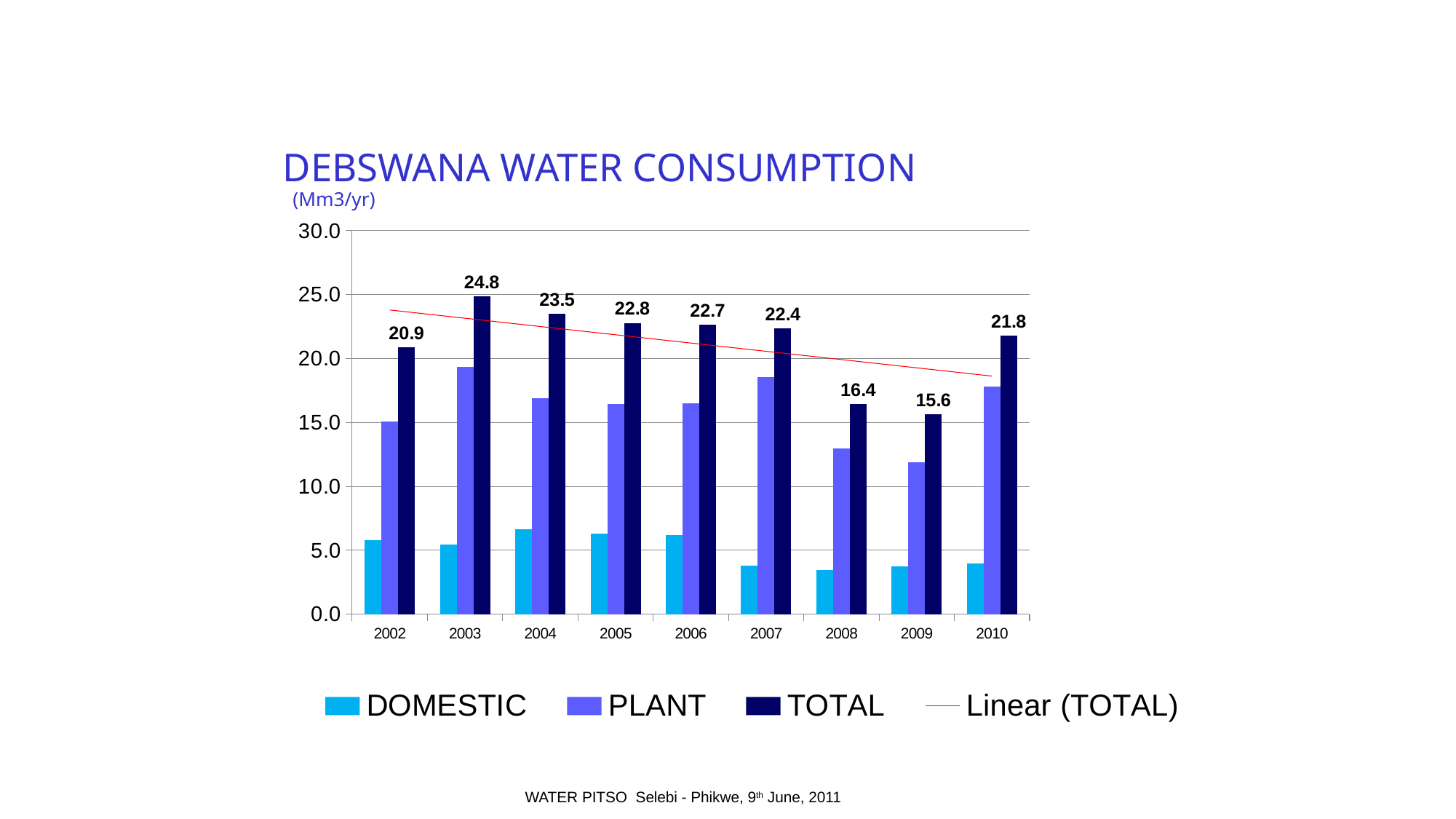
Which year has the lowest TOTAL water consumption? 2009 Is the PLANT value for 2009 greater or less than 15.0? less How many entries does the chart legend list? 4 What is the TOTAL water consumption value for 2009? 15.6 What is the TOTAL water consumption value for 2003? 24.8 How many years are shown on the x axis of the chart? 9 What is the difference between the TOTAL values for 2004 and 2005? 0.7 Is the DOMESTIC value for 2008 greater or less than 5.0? less Which year has the larger TOTAL value, 2002 or 2010? 2010 What kind of chart is used to show the water consumption data? bar chart What is the difference between the TOTAL values for 2003 and 2009? 9.2 Which year has the highest TOTAL water consumption? 2003